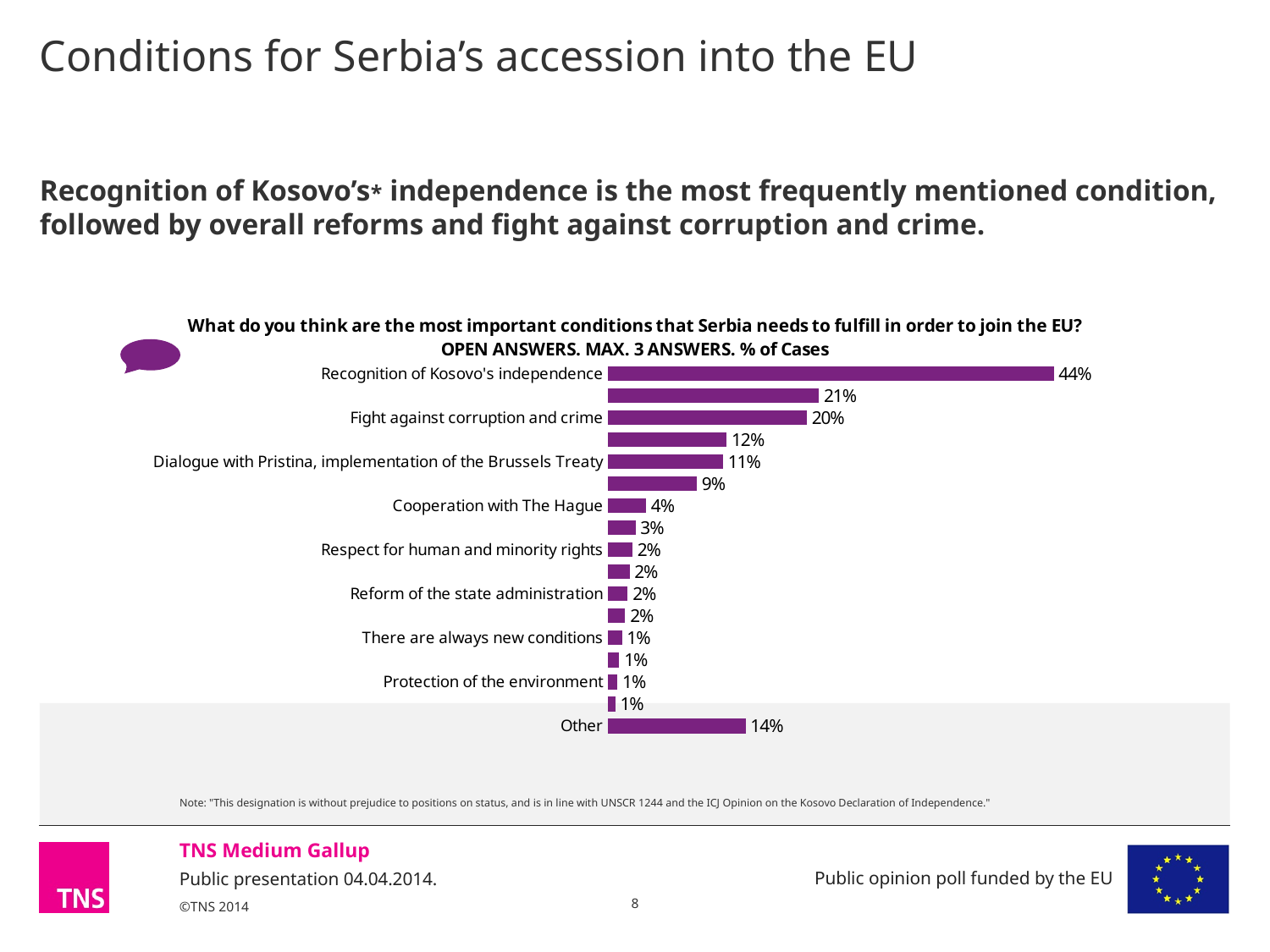
What is the value for Fight against corruption and crime? 20% What is the value for the Other category? 14% What is the difference between the values for Recognition of Kosovo's independence and Fight against corruption and crime? 24 percentage points What is the value for Cooperation with The Hague? 4% Which is larger, the value for Fight against corruption and crime or the value for Other? Fight against corruption and crime How many bars are plotted in the chart? 17 What percentage of cases mentioned Recognition of Kosovo's independence as a condition? 44% Which is larger, the value for Cooperation with The Hague or the value for Dialogue with Pristina, implementation of the Brussels Treaty? Dialogue with Pristina, implementation of the Brussels Treaty What is the value for Dialogue with Pristina, implementation of the Brussels Treaty? 11% What type of chart is shown on the slide? Bar chart What is the value for Protection of the environment? 1% Which condition has the highest percentage of cases? Recognition of Kosovo's independence